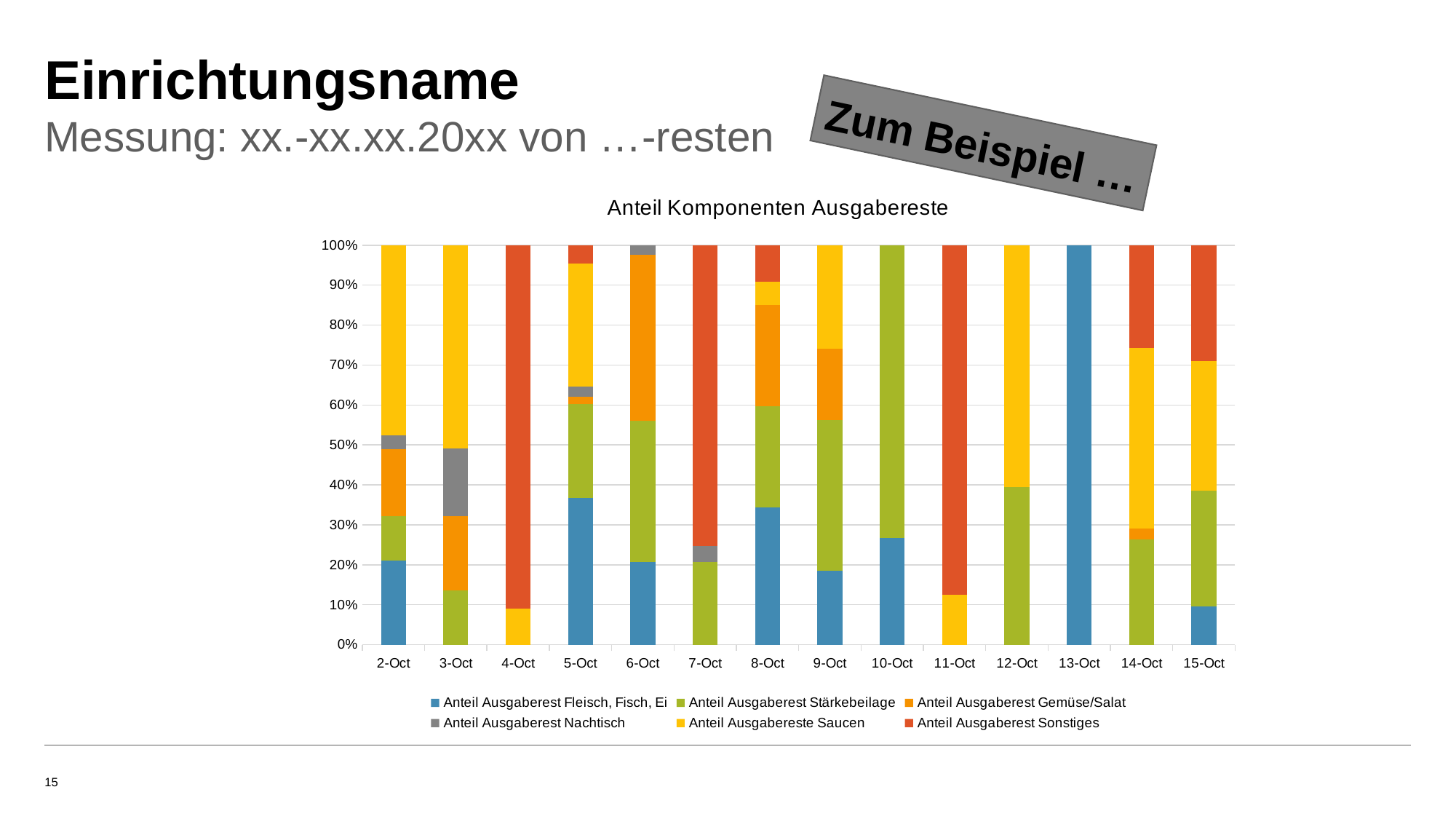
How many dates are shown on the x axis? 14 How many series does the legend list? 6 Which series makes up the entire bar for 13-Oct? Anteil Ausgaberest Fleisch, Fisch, Ei Is the share of Anteil Ausgaberest Fleisch, Fisch, Ei for 5-Oct greater or less than 30%? greater What is the total of the stacked bar for 2-Oct? 100% Which is larger: the share of Anteil Ausgaberest Fleisch, Fisch, Ei for 5-Oct or for 2-Oct? 5-Oct Which date has the largest share of Anteil Ausgaberest Fleisch, Fisch, Ei? 13-Oct Is the share of Anteil Ausgaberest Sonstiges for 4-Oct greater or less than 80%? greater What kind of chart is shown on the slide? Stacked bar chart Which date has the largest share of Anteil Ausgaberest Stärkebeilage? 10-Oct What is the title of the chart? Anteil Komponenten Ausgabereste Is the share of Anteil Ausgaberest Stärkebeilage for 12-Oct greater or less than 50%? less